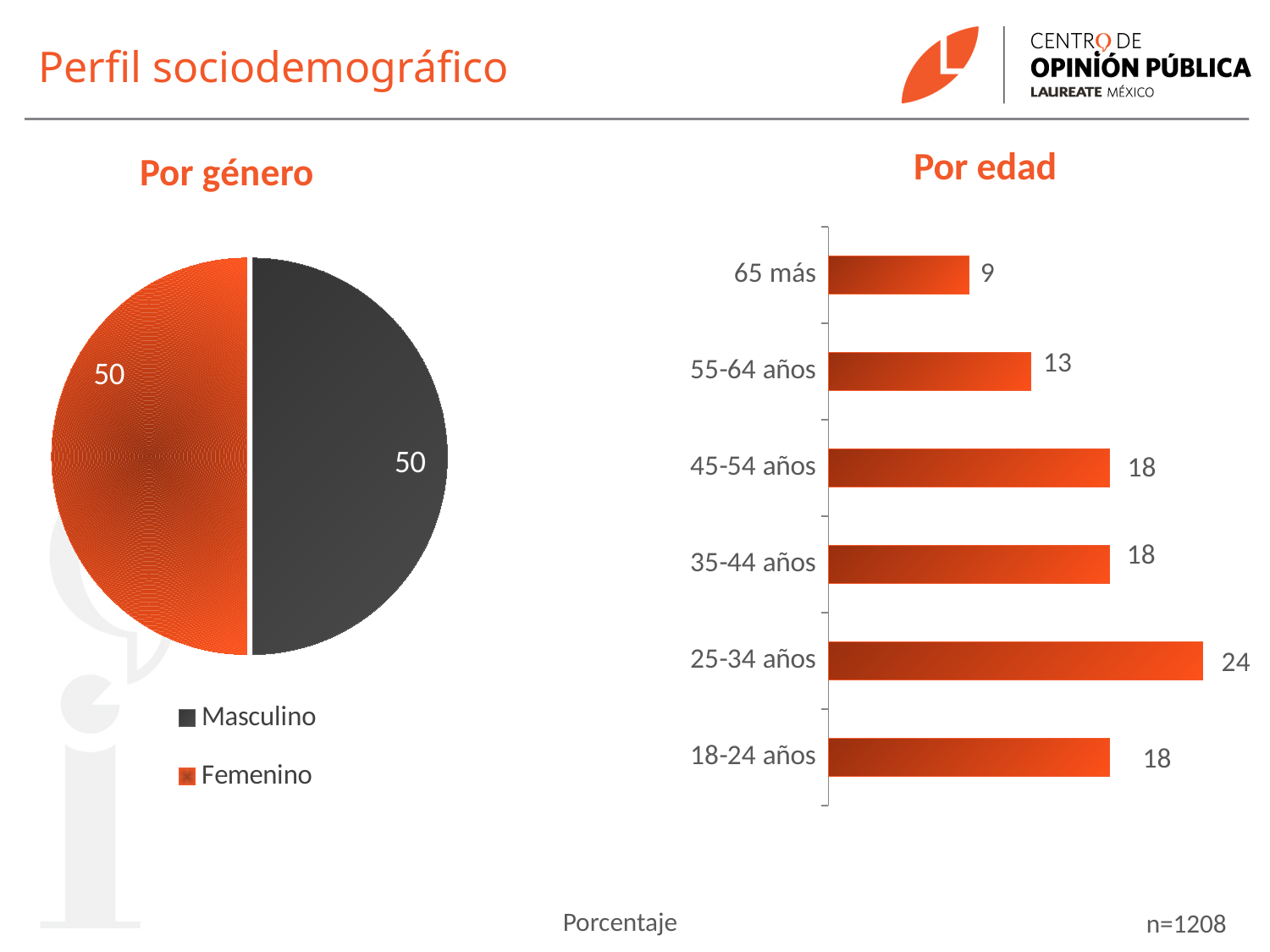
In the 'Por edad' chart, what is the value for 25-34 años? 24 In the 'Por edad' chart, what is the difference between the values for 25-34 años and 65 más? 15 In the 'Por género' chart, what kind of chart is shown? pie chart In the 'Por edad' chart, which age group has the lowest value? 65 más In the 'Por edad' chart, which age group has the highest value? 25-34 años In the 'Por género' chart, what share of the pie does Femenino represent? 50% In the 'Por edad' chart, what is the value for 55-64 años? 13 In the 'Por género' chart, what is the value for Masculino? 50 In the 'Por edad' chart, how many age categories are shown? 6 In the 'Por edad' chart, which is larger, the value for 55-64 años or the value for 45-54 años? 45-54 años In the 'Por edad' chart, what kind of chart is shown? bar chart In the 'Por género' chart, how many entries does the legend list? 2